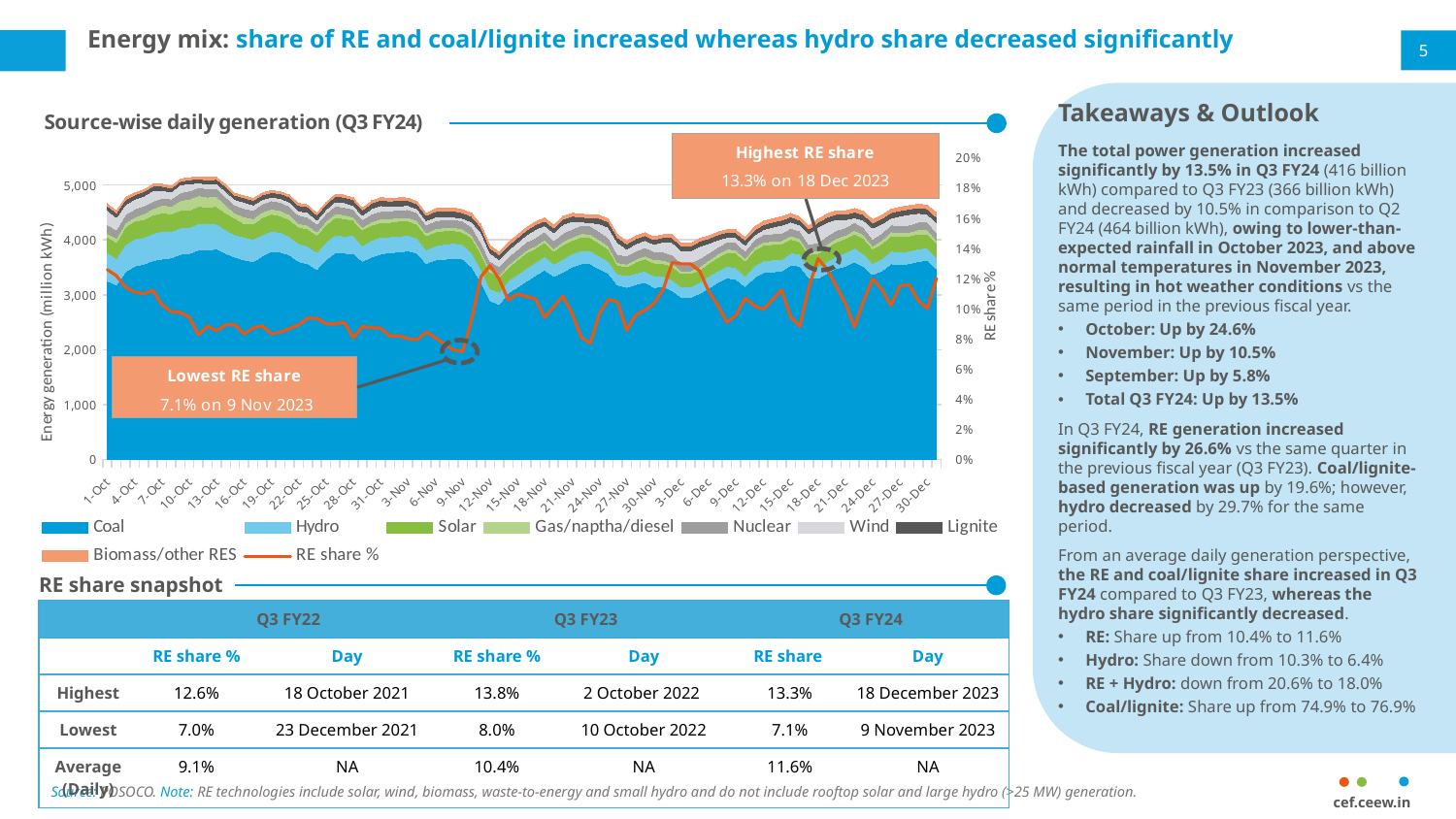
What is the title of the chart on the slide? Source-wise daily generation (Q3 FY24) Which is larger: the RE share on 18 Dec 2023 or the RE share on 9 Nov 2023? 18 Dec 2023 On which date did the highest RE share occur according to the chart annotation? 18 Dec 2023 What is the difference between the highest and lowest RE share values annotated on the chart? 6.2 percentage points On which date did the lowest RE share occur according to the chart annotation? 9 Nov 2023 What kind of chart is the Source-wise daily generation chart? Stacked area chart with a line Which source accounts for the largest share of daily generation in the chart? Coal What is the label of the right-hand vertical axis of the chart? RE share % Is the total daily generation on 1-Oct greater or less than 4,000 million kWh? greater What is the highest RE share shown on the Source-wise daily generation chart? 13.3% What is the lowest RE share shown on the Source-wise daily generation chart? 7.1% How many series does the legend of the Source-wise daily generation chart list? 9